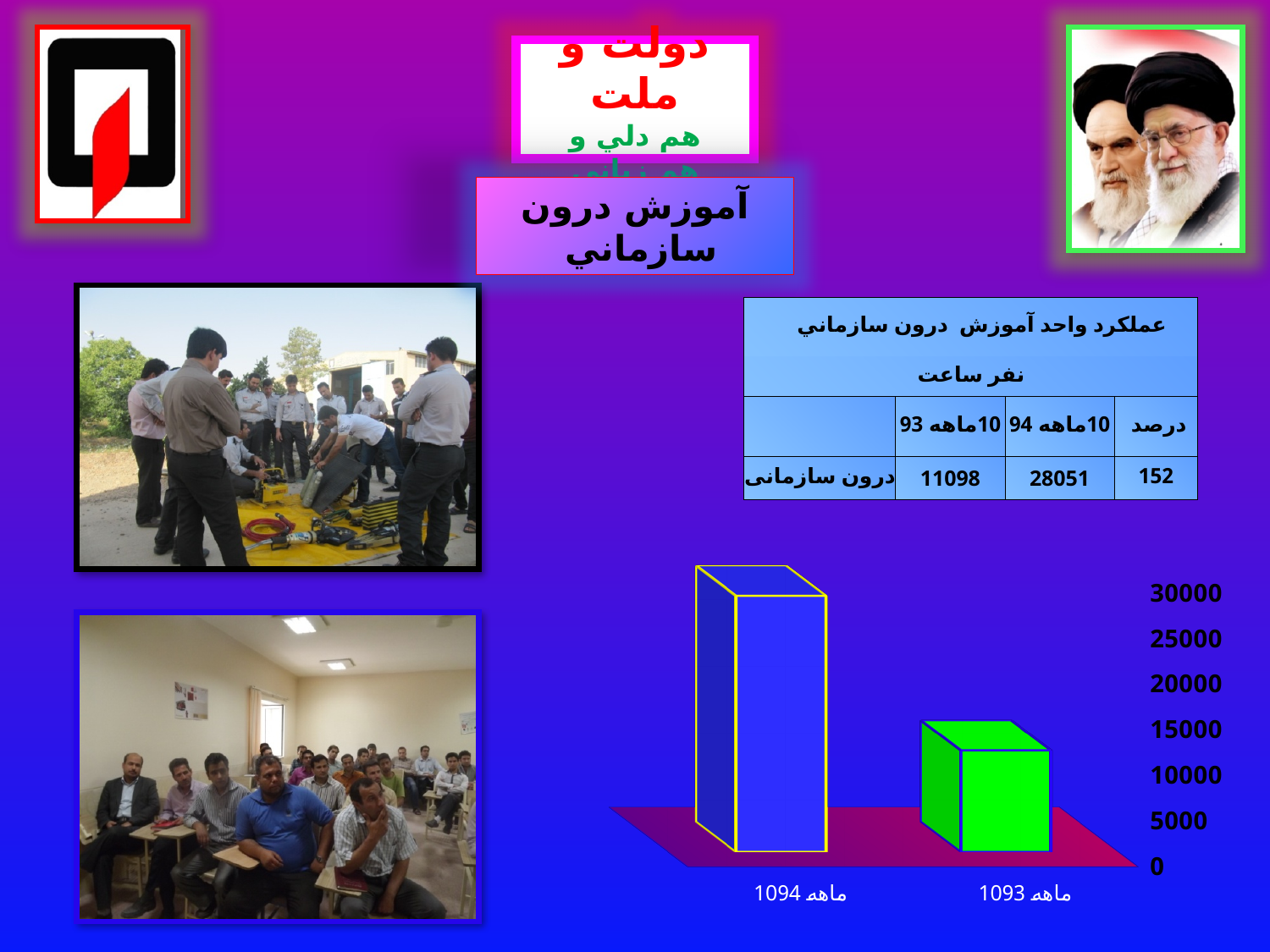
What kind of chart is shown on the slide? bar chart What colour is the bar for ماهه 1093? green Is the value for ماهه 1094 greater or less than 25000? greater What is the highest tick value shown on the chart's value axis? 30000 Which category has the lowest bar in the chart? ماهه 1093 Which bar is taller, ماهه 1094 or ماهه 1093? ماهه 1094 How many bars are plotted in the chart? 2 Is the value for ماهه 1093 greater or less than 10000? greater Is the value for ماهه 1093 greater or less than 15000? less Which category has the highest bar in the chart? ماهه 1094